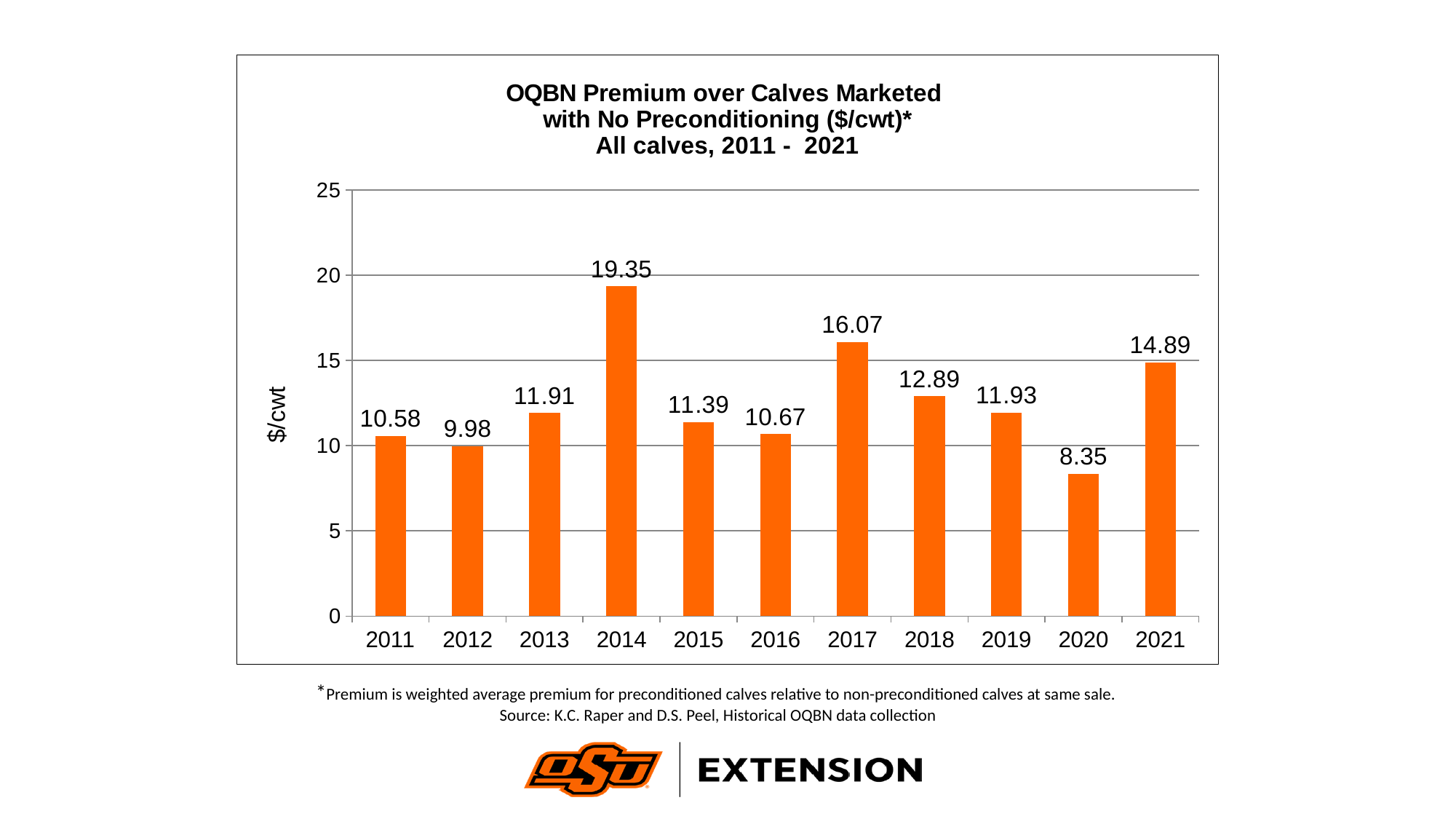
Is the value for 2012 greater or less than 10? less What is the OQBN premium value for 2014? 19.35 Which year has a larger premium, 2017 or 2018? 2017 What kind of chart is shown on the slide? bar chart What is the difference between the 2014 and 2020 premium values? 11.00 How many years are shown on the x axis? 11 What is the label on the y axis? $/cwt What is the OQBN premium value for 2021? 14.89 Does the premium rise or fall from 2020 to 2021? rise Which year has the highest OQBN premium? 2014 Which year has the lowest OQBN premium? 2020 What is the OQBN premium value for 2020? 8.35